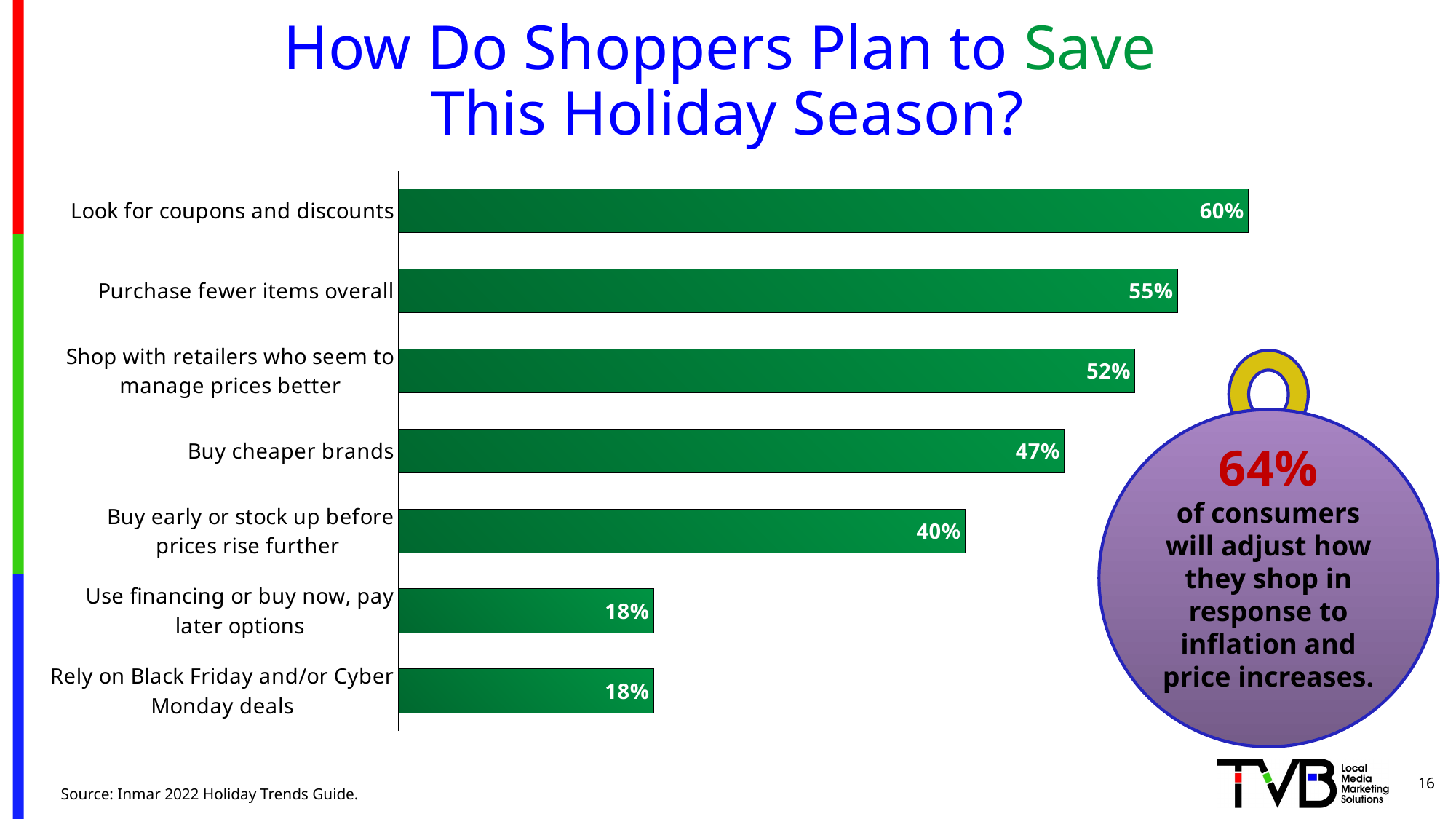
Which is larger: 'Purchase fewer items overall' or 'Buy cheaper brands'? Purchase fewer items overall What type of chart is shown on the slide? Bar chart What colour are the bars in the chart? Green What is the value for 'Shop with retailers who seem to manage prices better'? 52% What percentage of shoppers plan to look for coupons and discounts? 60% What percentage of shoppers plan to buy early or stock up before prices rise further? 40% What is the difference between 'Buy cheaper brands' and 'Use financing or buy now, pay later options'? 29% Which two categories share the same value of 18%? Use financing or buy now, pay later options; Rely on Black Friday and/or Cyber Monday deals What is the value for 'Buy cheaper brands'? 47% Which saving strategy has the highest percentage? Look for coupons and discounts What is the difference between 'Look for coupons and discounts' and 'Purchase fewer items overall'? 5% How many saving strategies are shown in the chart? 7